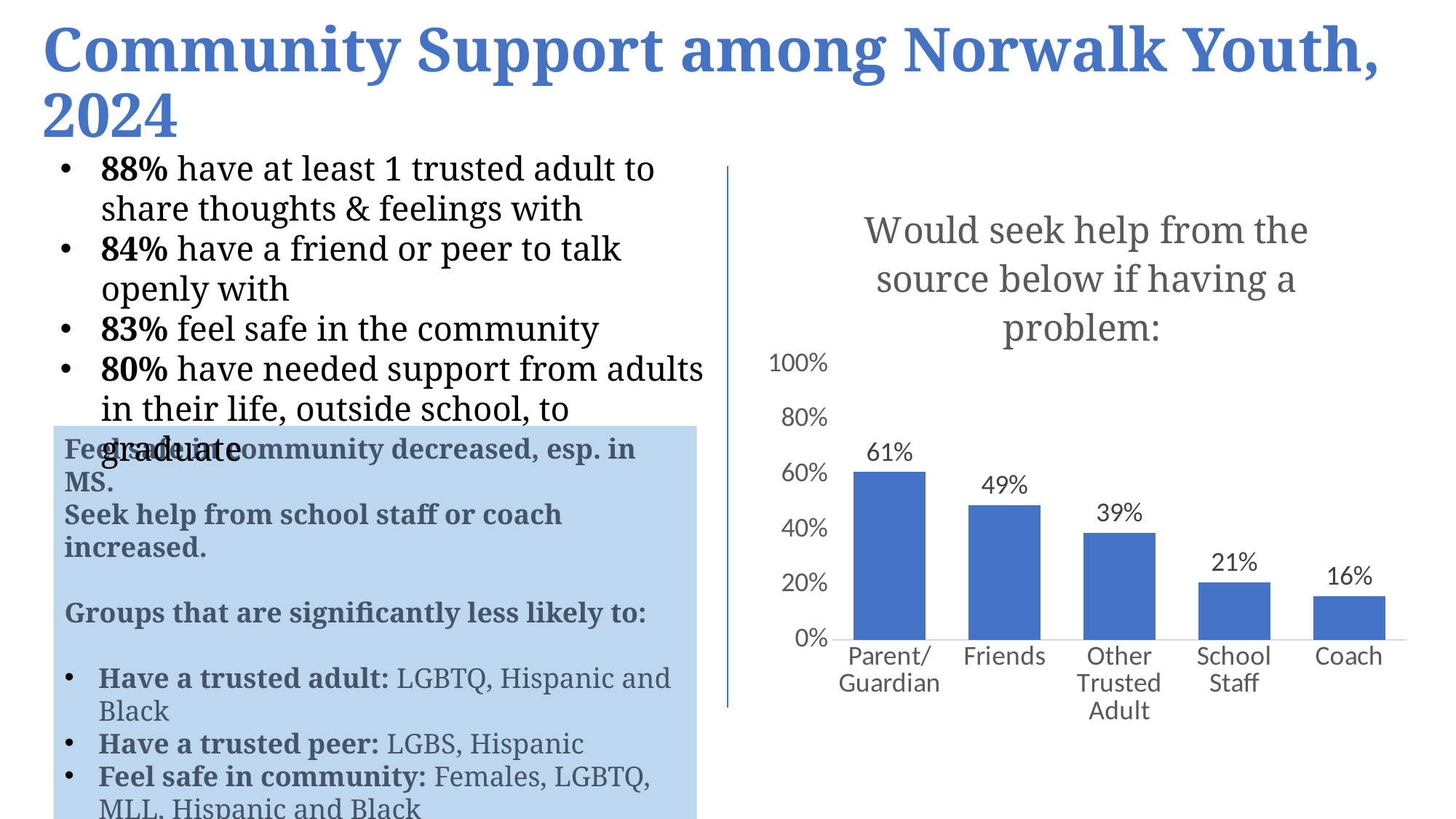
What kind of chart is shown on the slide? Bar chart How many sources of help are shown in the chart? 5 What is the value shown for Friends in the chart? 49% What is the value for School Staff in the chart? 21% What percentage of youth would seek help from a Parent/Guardian if having a problem? 61% Which source has the lowest percentage in the chart? Coach What is the difference between the values for Parent/Guardian and Friends? 12% Which is larger, the value for Friends or the value for Other Trusted Adult? Friends What is the difference between the values for School Staff and Coach? 5% Do the values rise or fall moving from left to right across the chart? Fall Which source has the highest percentage of youth who would seek help from it? Parent/Guardian What percentage would seek help from Other Trusted Adult? 39%